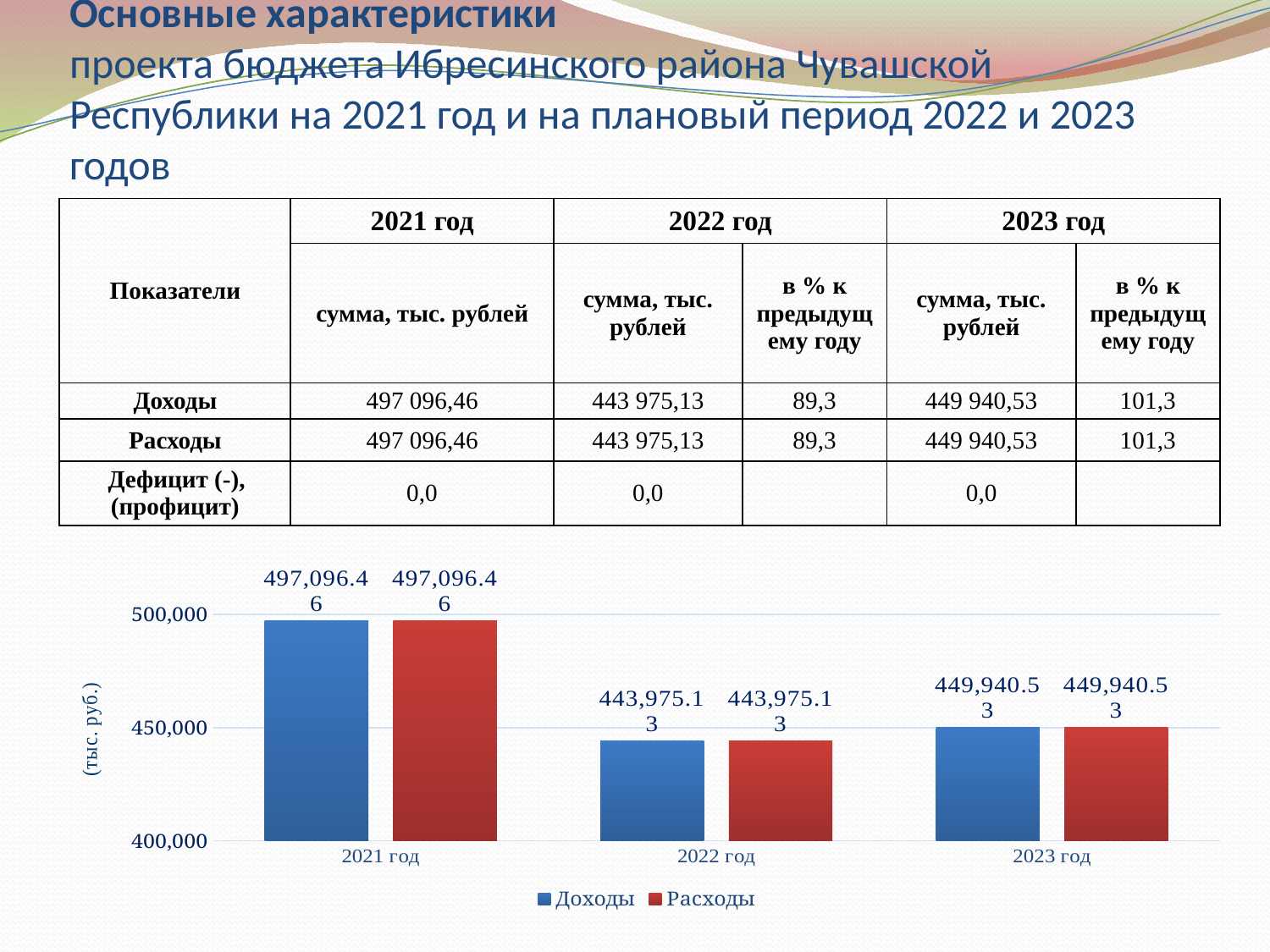
What kind of chart is shown on the slide? bar chart What is the value of Доходы for 2021 год in the chart? 497,096.46 How many series does the chart legend list? 2 Which is larger: Доходы in 2021 год or Доходы in 2023 год? 2021 год Which year has the lowest Расходы value in the chart? 2022 год What is the difference between Расходы in 2023 год and Расходы in 2022 год? 5,965.40 What is the difference between Доходы in 2021 год and Доходы in 2022 год? 53,121.33 How many years are shown on the x axis of the chart? 3 What is the value of Доходы for 2023 год in the chart? 449,940.53 Is the value for Доходы in 2022 год greater or less than 450,000? less What is the value of Расходы for 2022 год in the chart? 443,975.13 Which year has the highest Доходы value in the chart? 2021 год